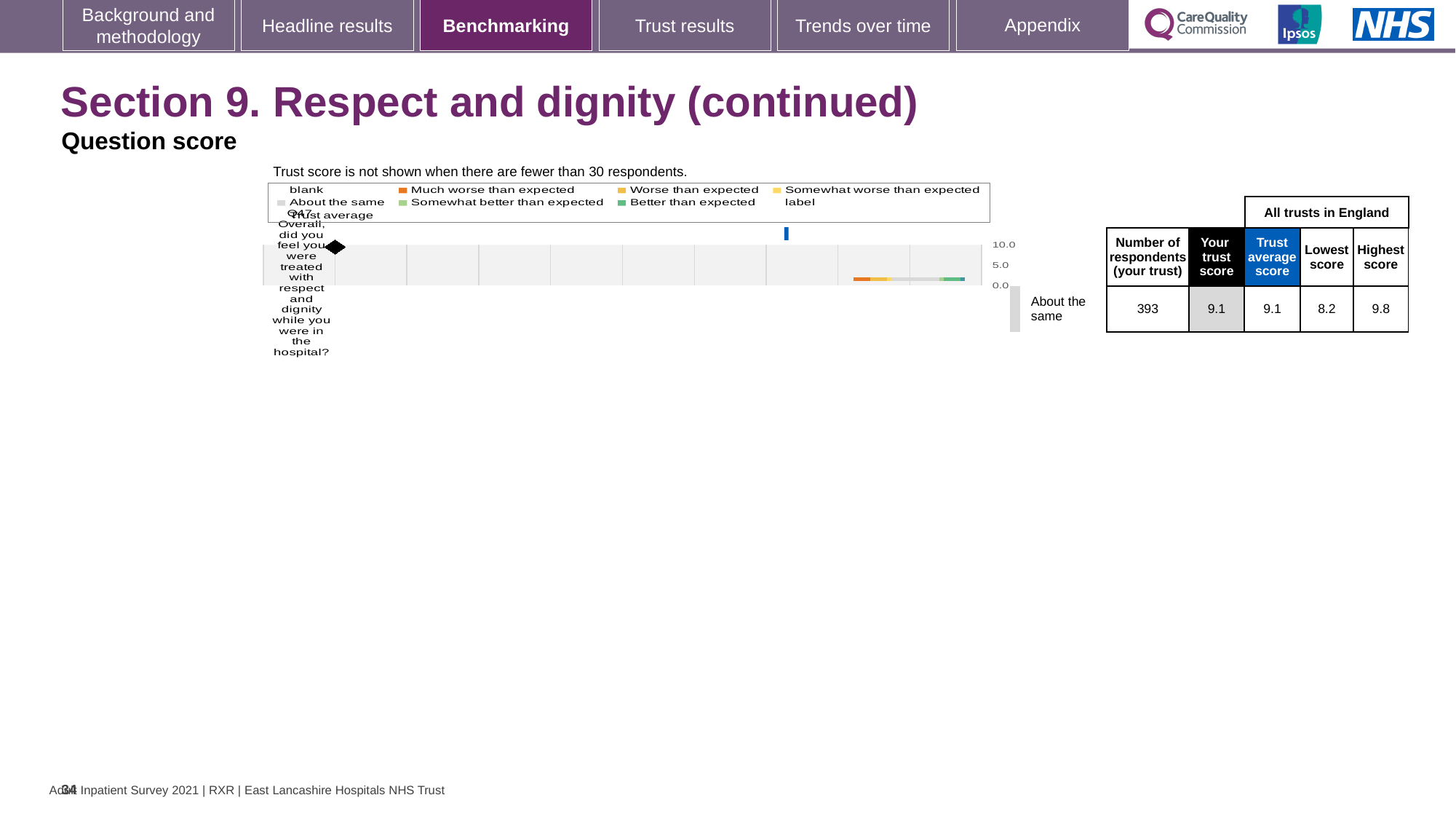
What is the trust average score for Q47? 9.1 What kind of chart is shown on the slide for Q47? bar chart Which colour does the legend use for 'Much worse than expected'? orange What is the highest tick value shown on the chart's score axis? 10.0 What benchmark rating is shown for Q47 next to the chart? About the same What is the highest score among all trusts in England for Q47? 9.8 What is your trust score for Q47? 9.1 What is the lowest score among all trusts in England for Q47? 8.2 Is the trust average marker for Q47 greater or less than 5.0 on the score axis? greater How many questions (categories) are plotted in the chart? 1 What is the number of respondents for your trust shown for Q47? 393 What is the difference between the highest score and the lowest score for Q47? 1.6